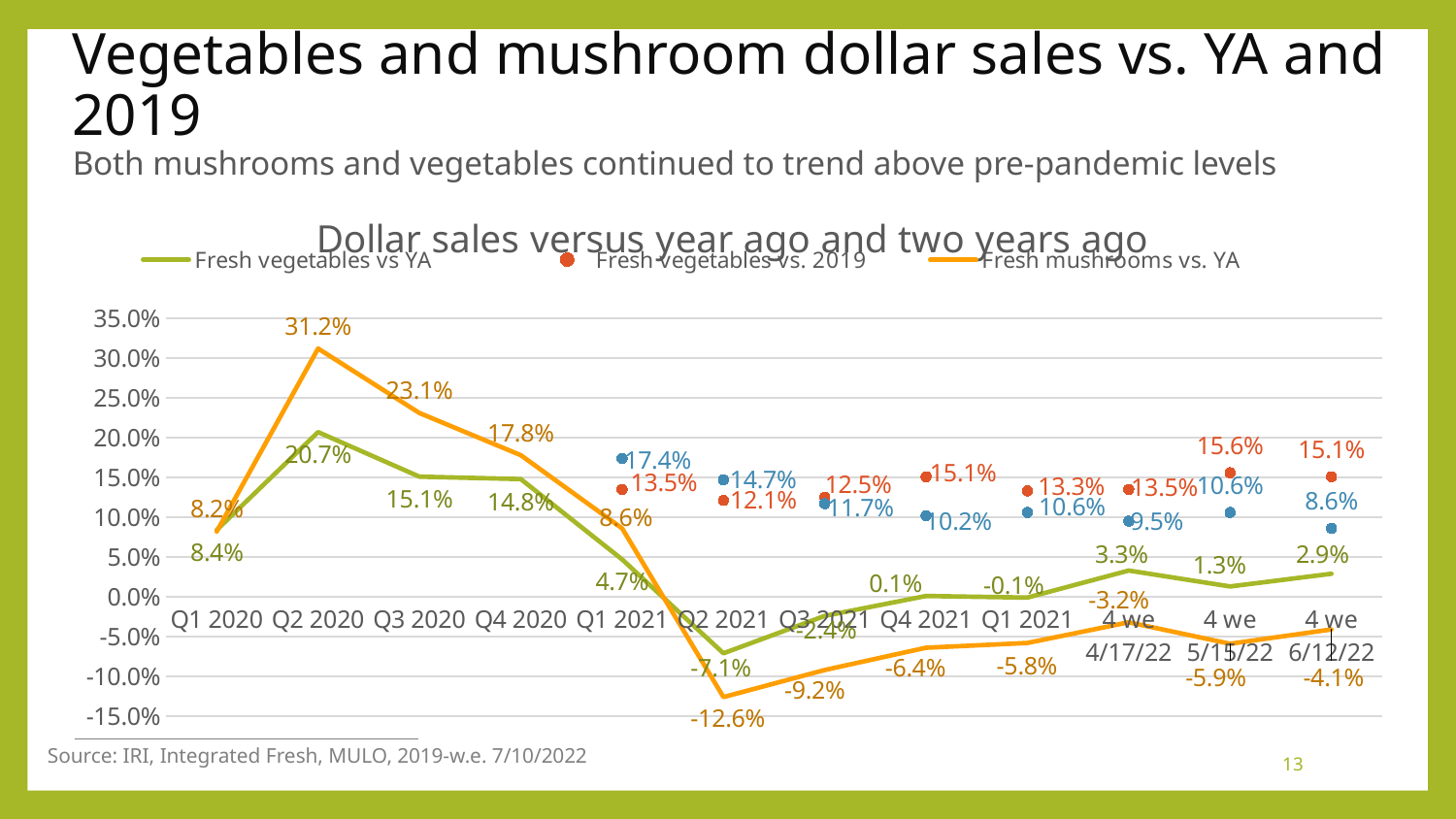
In which period is Fresh mushrooms vs. YA lowest? Q2 2021 In Q3 2020, which is larger: Fresh mushrooms vs. YA or Fresh vegetables vs YA? Fresh mushrooms vs. YA In which period is Fresh mushrooms vs. YA highest? Q2 2020 What type of chart is shown? Line chart What is the value of Fresh vegetables vs YA for the 4 weeks ending 6/12/22? 2.9% How many periods are shown on the x axis? 12 What is the value of Fresh mushrooms vs. YA in Q2 2020? 31.2% What is the value of Fresh vegetables vs. 2019 in Q4 2021? 15.1% In which period is Fresh vegetables vs. 2019 highest? 4 we 5/15/22 What is the value of Fresh vegetables vs YA in Q2 2021? -7.1% What is the difference between Fresh mushrooms vs. YA and Fresh vegetables vs YA in Q2 2020? 10.5 percentage points How many series does the legend list? 3